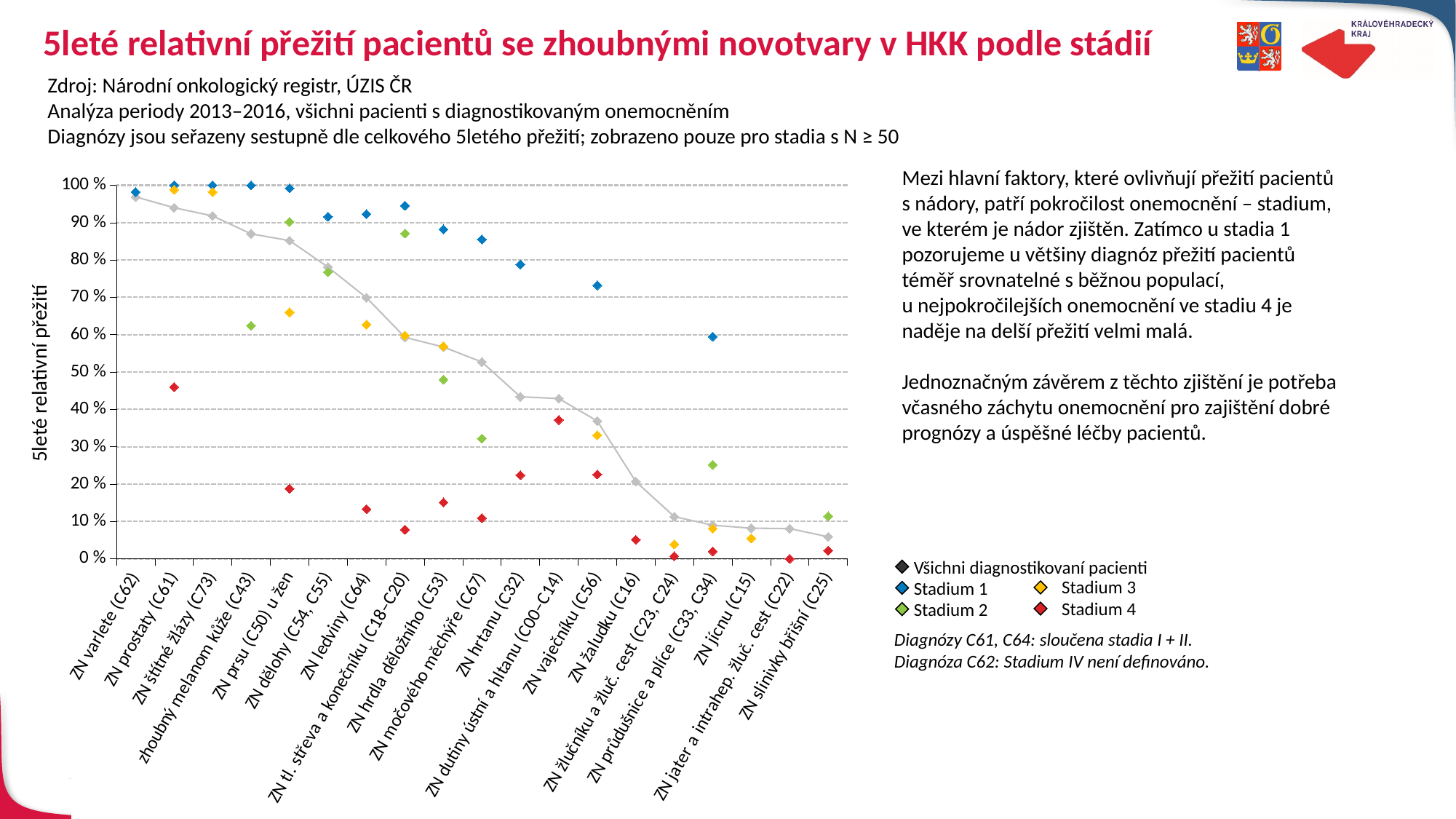
Which is larger: the Stadium 4 value for ZN prostaty (C61) or the Stadium 4 value for ZN ledviny (C64)? ZN prostaty (C61) Is the Stadium 1 value for ZN vaječníku (C56) greater or less than 60 %? greater How many diagnoses (categories) are shown on the x axis of the chart? 19 What is the label of the chart's y axis? 5leté relativní přežití Does the Všichni diagnostikovaní pacienti series rise or fall from left to right along the x axis? fall Is the Všichni diagnostikovaní pacienti value for ZN žaludku (C16) greater or less than 30 %? less Is the Stadium 4 value for ZN prsu (C50) u žen greater or less than 30 %? less How many series does the chart legend list? 5 Which diagnosis has the highest value for Všichni diagnostikovaní pacienti? ZN varlete (C62) Which diagnosis has the lowest value for Všichni diagnostikovaní pacienti? ZN slinivky břišní (C25) Which is larger: the Stadium 1 value for ZN ledviny (C64) or the Stadium 1 value for ZN hrtanu (C32)? ZN ledviny (C64)